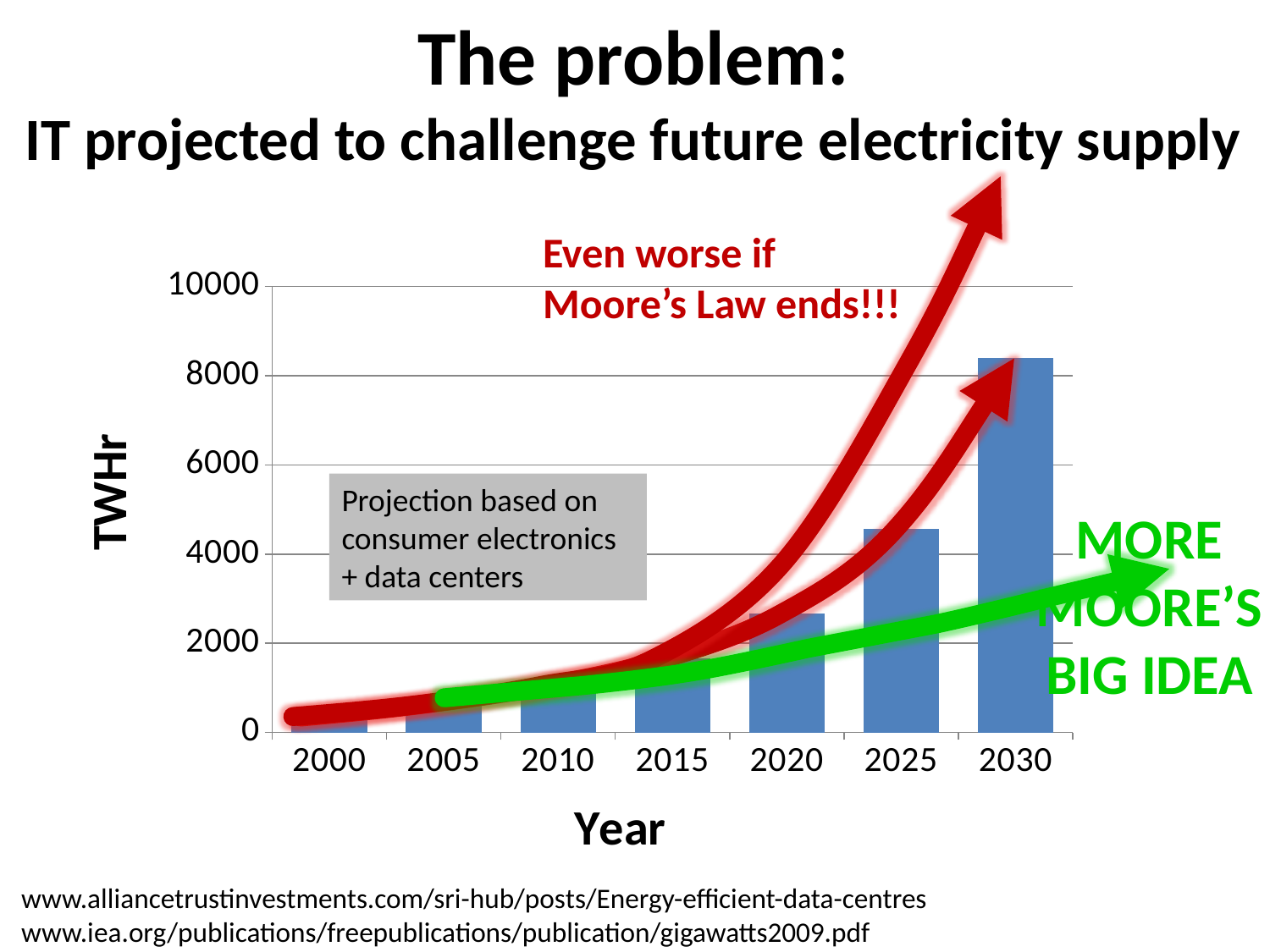
Is the value for 2025 greater or less than 4000? greater Is the value for 2015 greater or less than 2000? less Which year has the highest bar in the chart? 2030 How many years are shown on the x axis of the chart? 7 Which year has the lowest bar in the chart? 2000 Is the value for 2020 greater or less than 4000? less What kind of chart is shown on the slide? bar chart Do the bar values rise or fall from 2000 to 2030? rise What is the label of the y axis of the chart? TWHr Which is larger, the value for 2025 or the value for 2020? 2025 What is the label of the x axis of the chart? Year